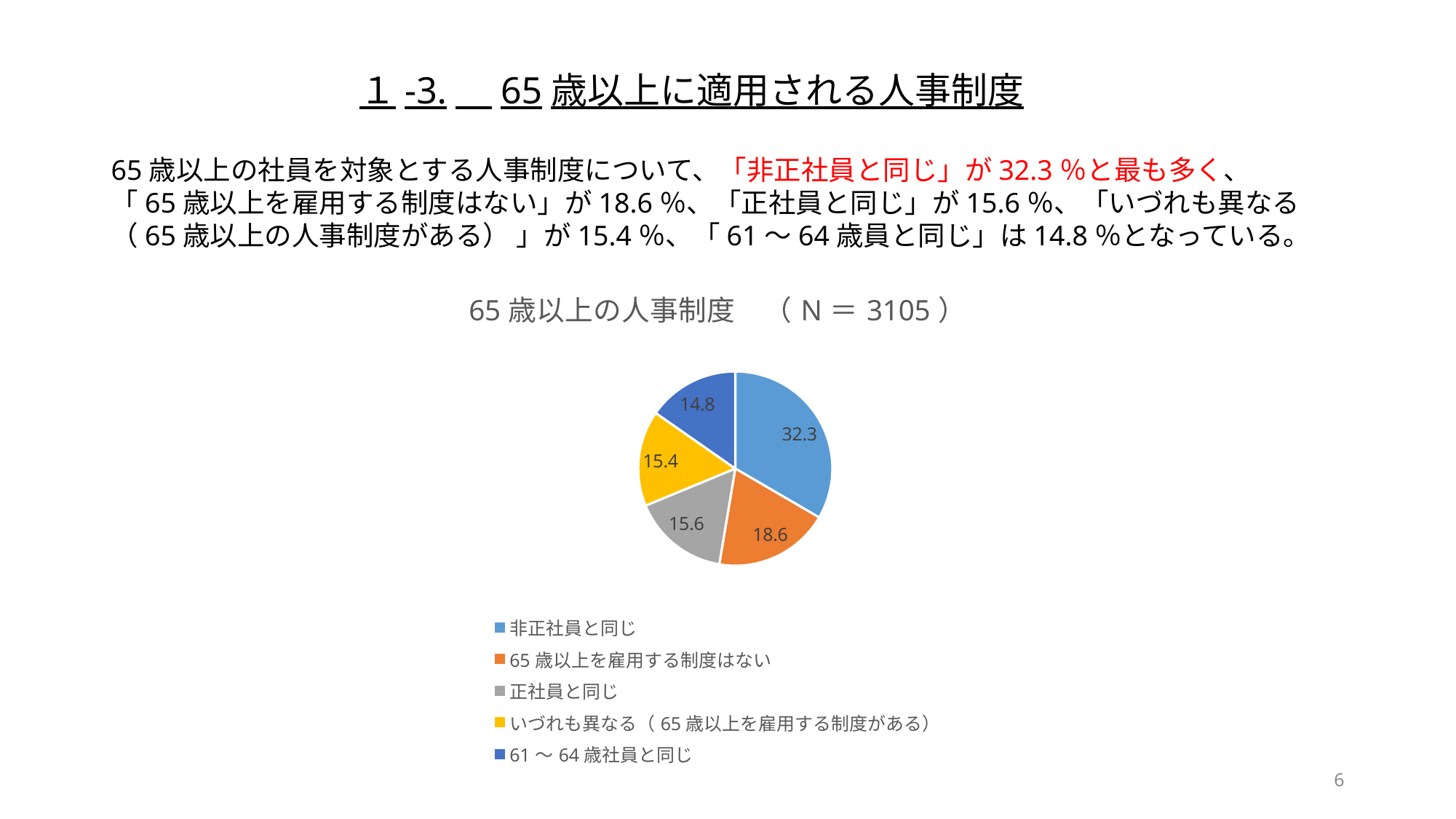
How many slices does the pie chart have? 5 What type of chart is shown on the slide? pie chart What is the value for 正社員と同じ in the pie chart? 15.6 Which category has the largest slice in the pie chart? 非正社員と同じ What is the difference between the values for 非正社員と同じ and 65歳以上を雇用する制度はない? 13.7 Which category has the smallest slice in the pie chart? 61～64歳社員と同じ What is the value for 非正社員と同じ in the pie chart? 32.3 What is the value for 61～64歳社員と同じ in the pie chart? 14.8 What is the value for 65歳以上を雇用する制度はない in the pie chart? 18.6 Which is larger, the value for 正社員と同じ or the value for 61～64歳社員と同じ? 正社員と同じ What colour is the slice for いづれも異なる（65歳以上を雇用する制度がある）? yellow What is the title of the pie chart? 65歳以上の人事制度 （N＝3105）